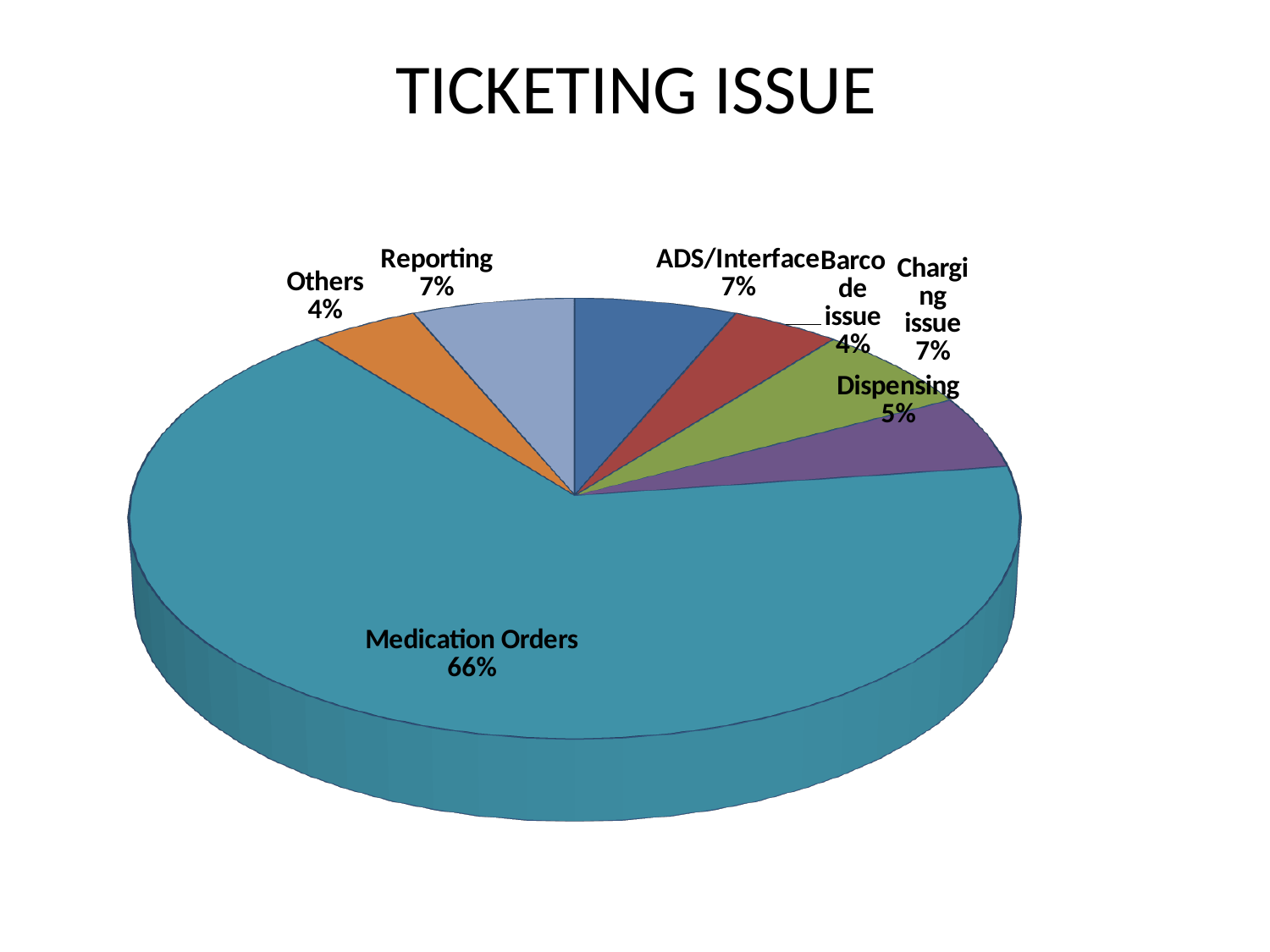
How many slices does the pie chart have? 7 What is the title of the chart? TICKETING ISSUE Which is larger, the share for Dispensing or the share for Barcode issue? Dispensing Which category has the largest slice of the pie? Medication Orders What percentage is shown for Barcode issue? 4% What percentage is shown for Dispensing? 5% What kind of chart is shown on the slide? pie chart What percentage is shown for Charging issue? 7% What percentage is shown for Reporting? 7% What is the difference in percentage points between Medication Orders and ADS/Interface? 59 What share of the pie does Medication Orders take? 66% What is the difference in percentage points between Reporting and Others? 3